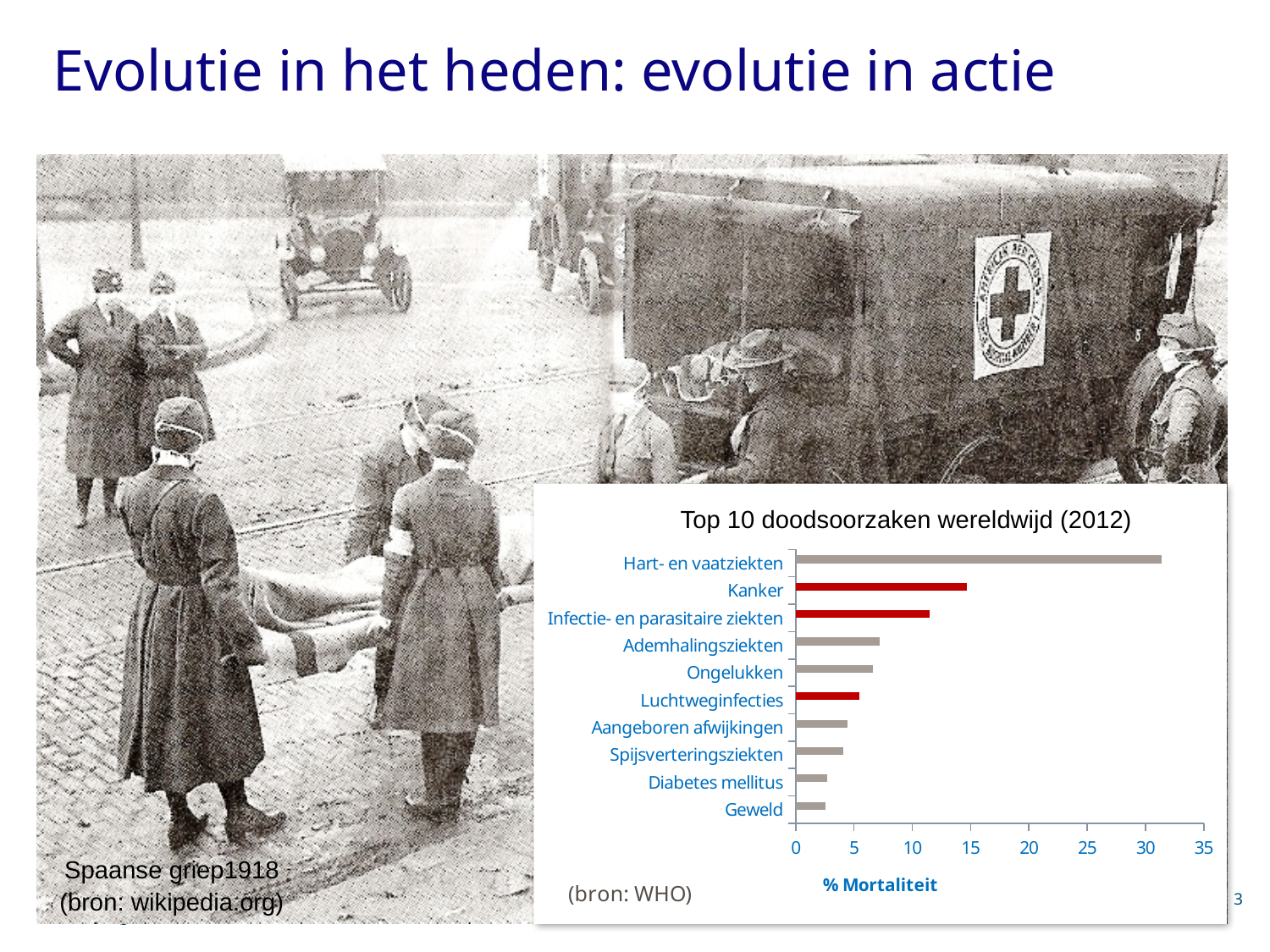
Which has a higher % Mortaliteit, Kanker or Infectie- en parasitaire ziekten? Kanker Which cause of death has the highest % Mortaliteit in the chart? Hart- en vaatziekten How many causes of death are listed in the chart? 10 Is the value for Hart- en vaatziekten greater or less than 25? greater Is the value for Geweld greater or less than 5? less What is the label of the horizontal axis of the chart? % Mortaliteit Is the value for Ademhalingsziekten greater or less than 10? less What is the title of the chart? Top 10 doodsoorzaken wereldwijd (2012) What type of chart is shown on the slide? bar chart Which has a higher % Mortaliteit, Luchtweginfecties or Diabetes mellitus? Luchtweginfecties